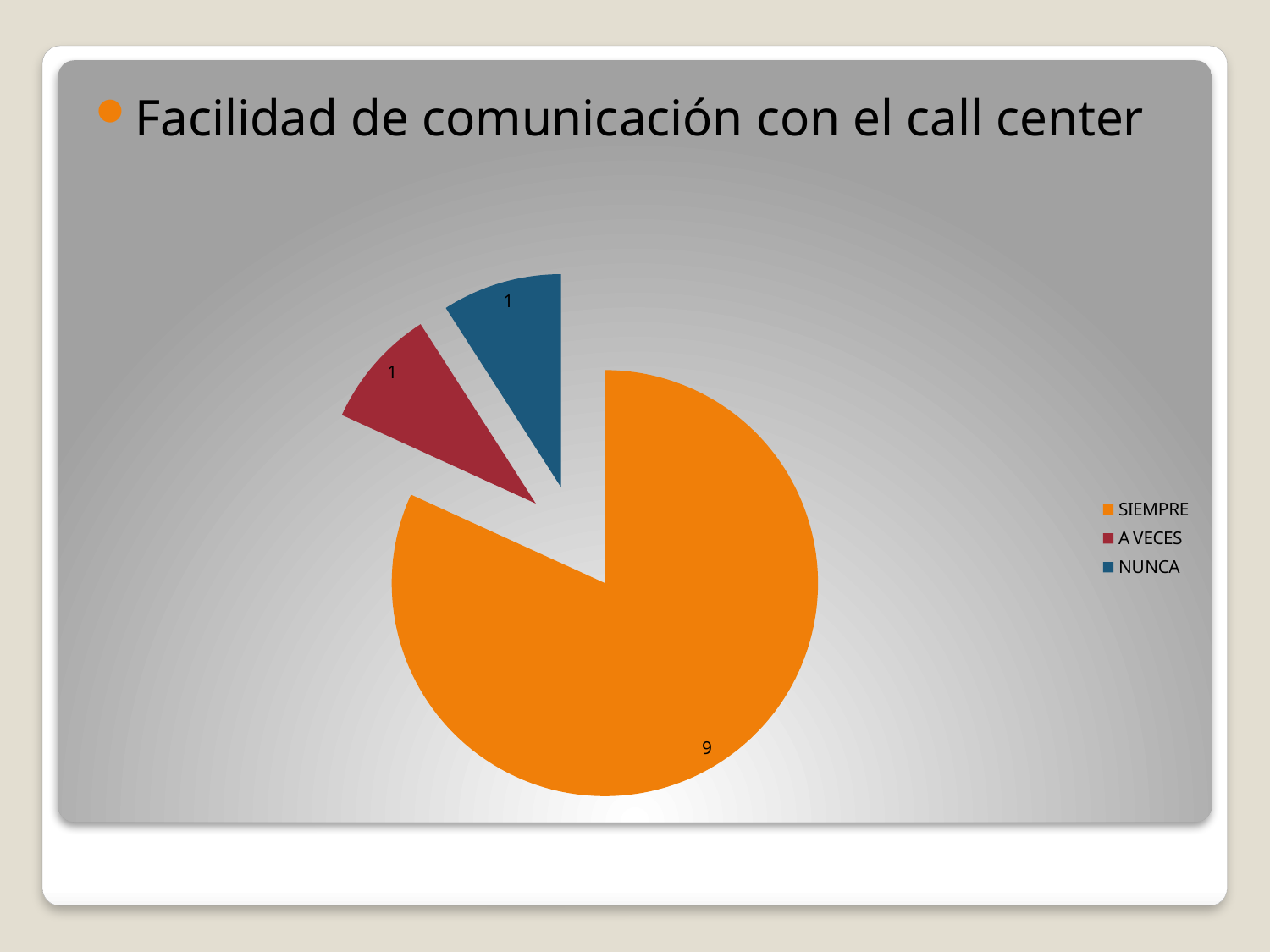
What is the value for SIEMPRE? 9 Which is larger, the value for SIEMPRE or the value for NUNCA? SIEMPRE What is the title text shown above the chart? Facilidad de comunicación con el call center What kind of chart is shown on the slide? pie chart How many categories does the legend list? 3 What colour is the SIEMPRE slice? orange Which category has the largest slice? SIEMPRE What is the difference between the values for SIEMPRE and A VECES? 8 What is the total of all slices in the pie? 11 What is the value for NUNCA? 1 What is the value for A VECES? 1